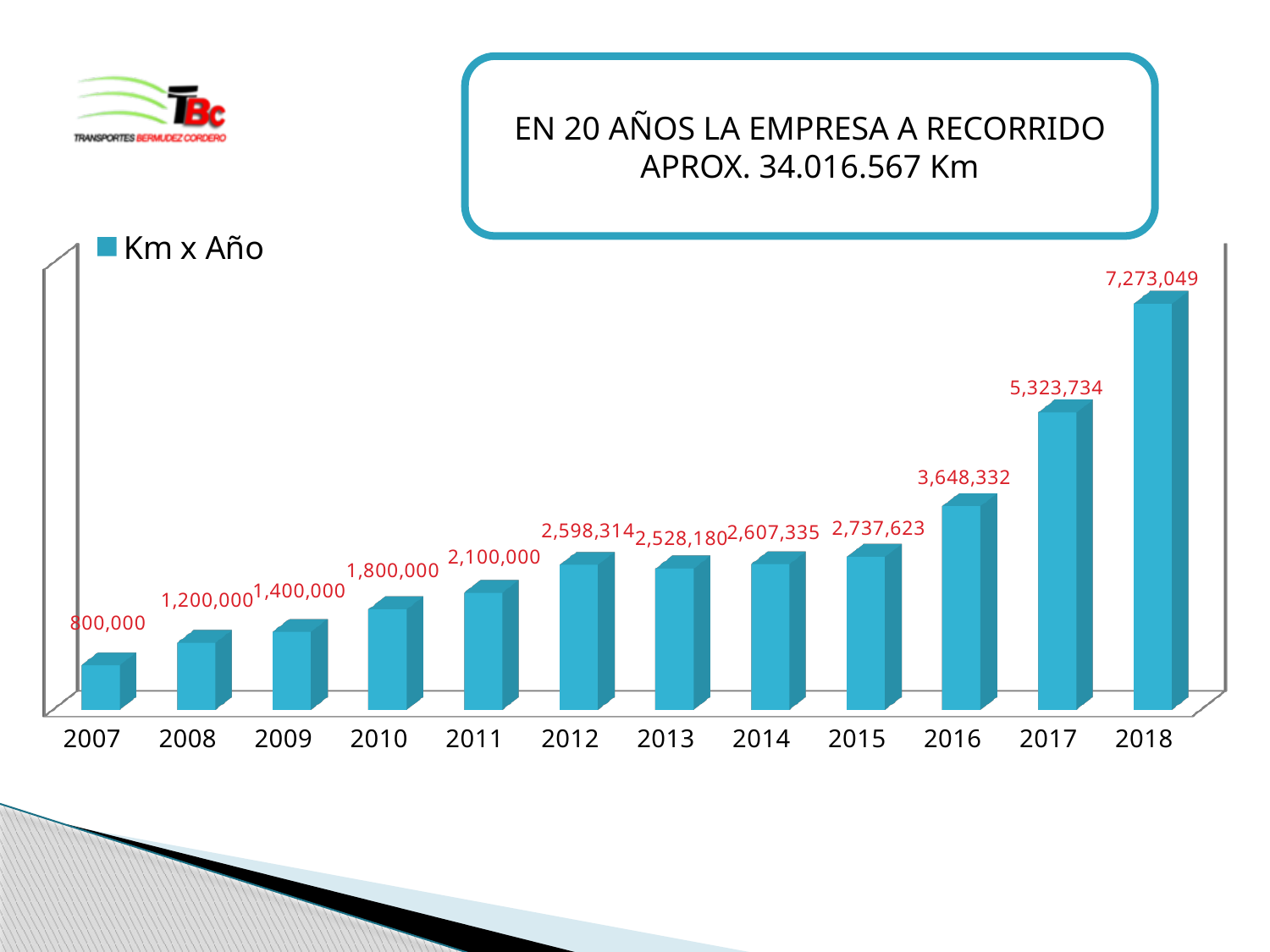
What is the value for 2007 in the Km x Año chart? 800,000 What is the name of the series shown in the legend? Km x Año What is the value for 2018 in the Km x Año chart? 7,273,049 What is the difference between the values for 2016 and 2015? 910,709 What is the difference between the values for 2018 and 2017? 1,949,315 Which year has the highest value in the Km x Año chart? 2018 How many series does the legend list? 1 How many years are shown on the x axis of the chart? 12 Which year has the larger value, 2012 or 2013? 2012 What kind of chart is shown on the slide? Bar chart Which year has the lowest value in the Km x Año chart? 2007 What is the value for 2012 in the Km x Año chart? 2,598,314